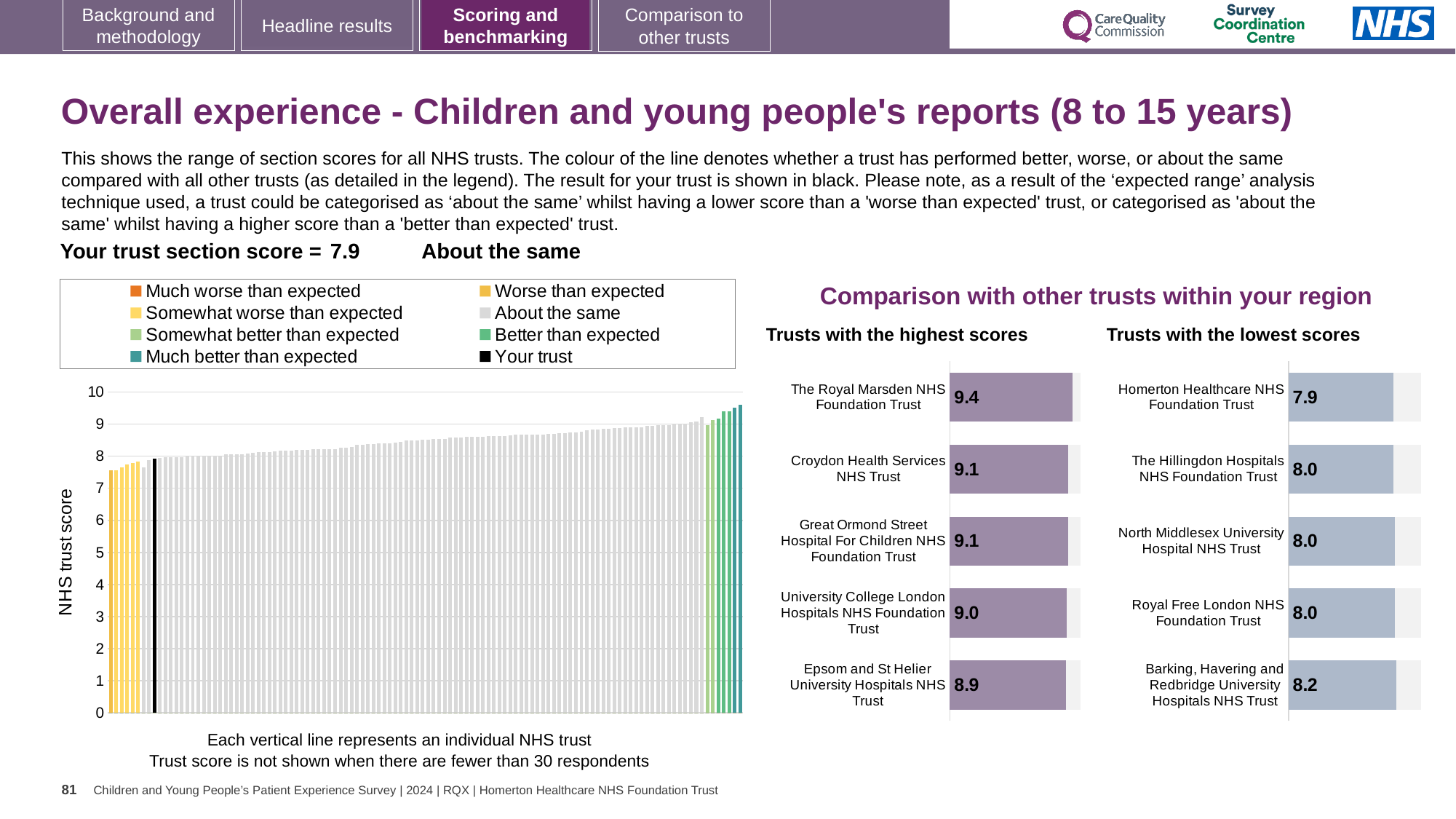
In the 'Trusts with the highest scores' chart, what is the difference between the scores of The Royal Marsden NHS Foundation Trust and University College London Hospitals NHS Foundation Trust? 0.4 In the large chart on the left, do the trust scores rise or fall from left to right? rise In the 'Trusts with the lowest scores' chart, what is the score for Homerton Healthcare NHS Foundation Trust? 7.9 In the 'Trusts with the highest scores' chart, what is the score for Epsom and St Helier University Hospitals NHS Trust? 8.9 In the 'Trusts with the highest scores' chart, which has the larger score: Croydon Health Services NHS Trust or Epsom and St Helier University Hospitals NHS Trust? Croydon Health Services NHS Trust How many trusts are shown in the 'Trusts with the lowest scores' chart? 5 In the 'Trusts with the lowest scores' chart, which trust has the lowest score? Homerton Healthcare NHS Foundation Trust In the 'Trusts with the lowest scores' chart, what is the score for Barking, Havering and Redbridge University Hospitals NHS Trust? 8.2 In the 'Trusts with the highest scores' chart, which trust has the highest score? The Royal Marsden NHS Foundation Trust In the 'Trusts with the highest scores' chart, what is the score for The Royal Marsden NHS Foundation Trust? 9.4 In the large chart on the left, what is the label of the vertical axis? NHS trust score In the 'Trusts with the lowest scores' chart, what is the difference between the scores of Barking, Havering and Redbridge University Hospitals NHS Trust and Homerton Healthcare NHS Foundation Trust? 0.3